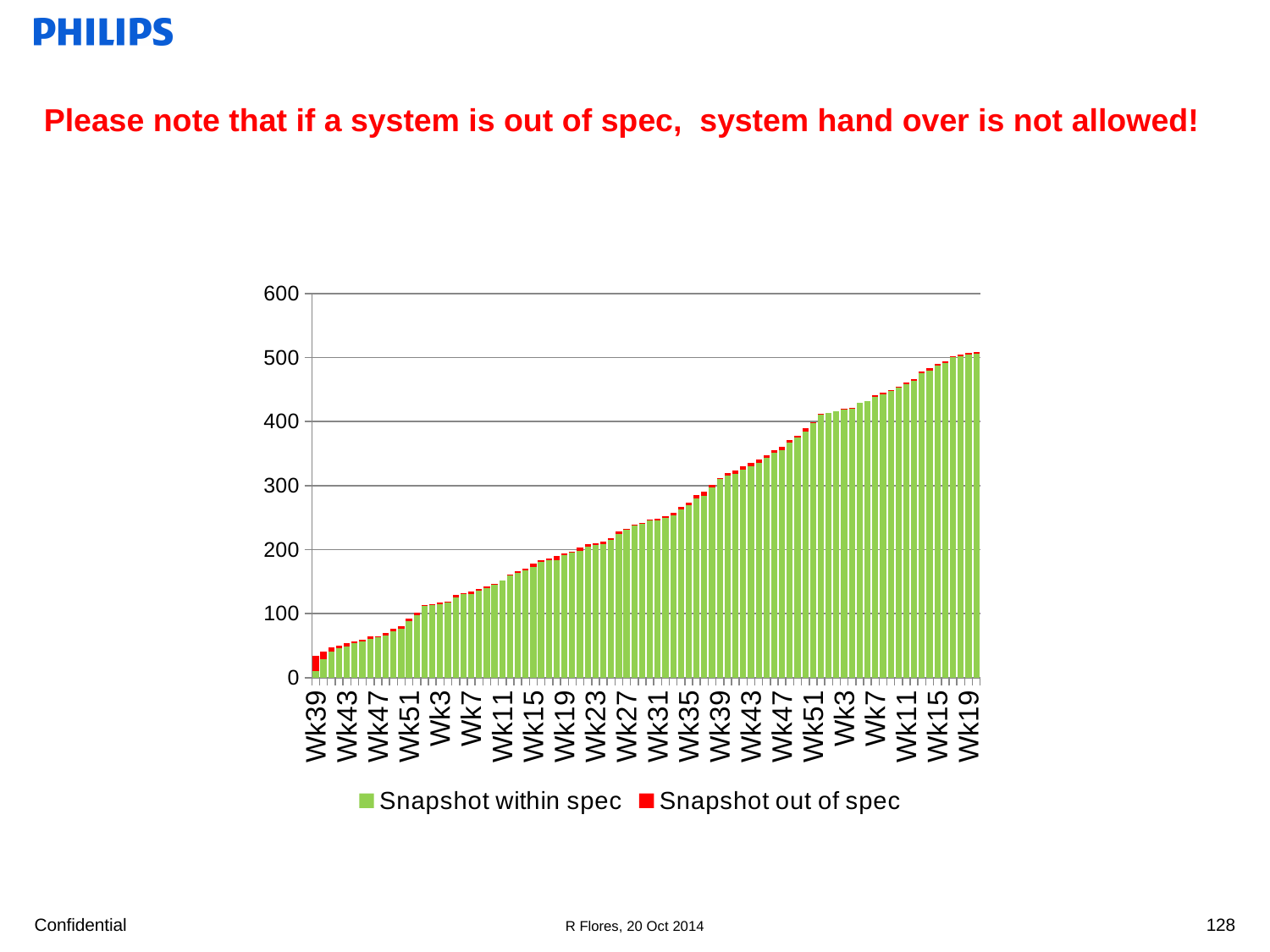
Is the total for the leftmost bar (first Wk39) greater or less than 100? less Which is larger, the total for the rightmost bar (Wk19) or the total for the first Wk27 bar? Wk19 Is the total for the rightmost bar (Wk19) greater or less than 500? greater Which week has the lowest stacked bar total? Wk39 (leftmost bar) What are the two series named in the legend? Snapshot within spec, Snapshot out of spec Which colour represents the 'Snapshot out of spec' series? red What kind of chart is shown on the slide? stacked bar chart Is the total for the first Wk11 bar greater or less than 200? less Do the stacked bar totals rise or fall from left to right along the x axis? rise How many series does the chart legend list? 2